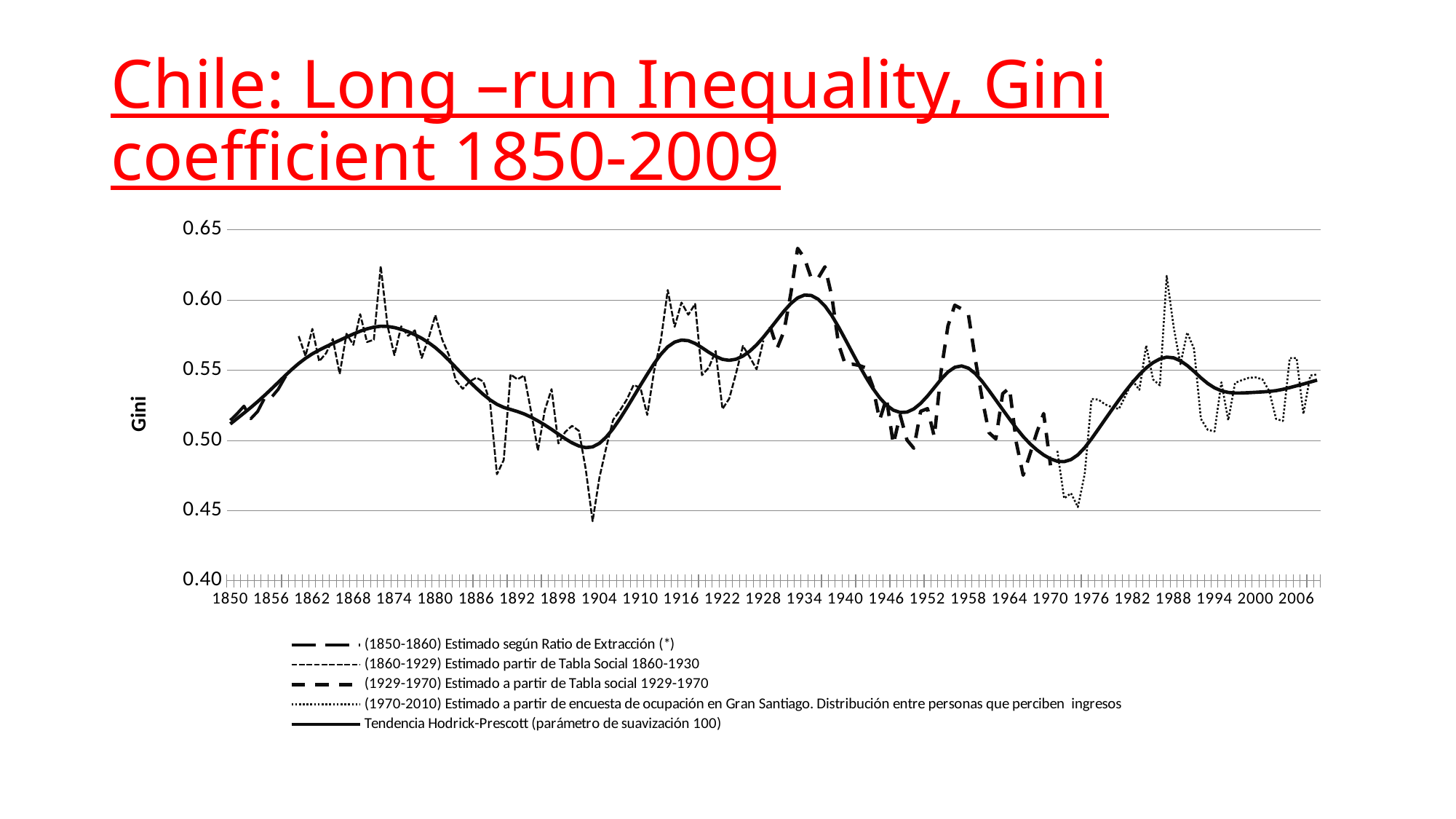
What kind of chart is shown on the slide? line chart Is the lowest point of the (1860-1929) Tabla Social series, around 1903, greater or less than 0.50? less What is the label on the vertical axis? Gini Is the value of the Tendencia Hodrick-Prescott trend line around 1934 greater or less than 0.55? greater Is the lowest point of the (1970-2010) encuesta de ocupación series, around 1974, greater or less than 0.50? less How many series does the legend list? 5 Does the Tendencia Hodrick-Prescott trend line rise or fall between 1850 and 1872? rise Does the Tendencia Hodrick-Prescott trend line rise or fall between 1904 and 1916? rise Does the Tendencia Hodrick-Prescott trend line rise or fall between 1934 and 1972? fall What is the title of the slide's chart? Chile: Long –run Inequality, Gini coefficient 1850-2009